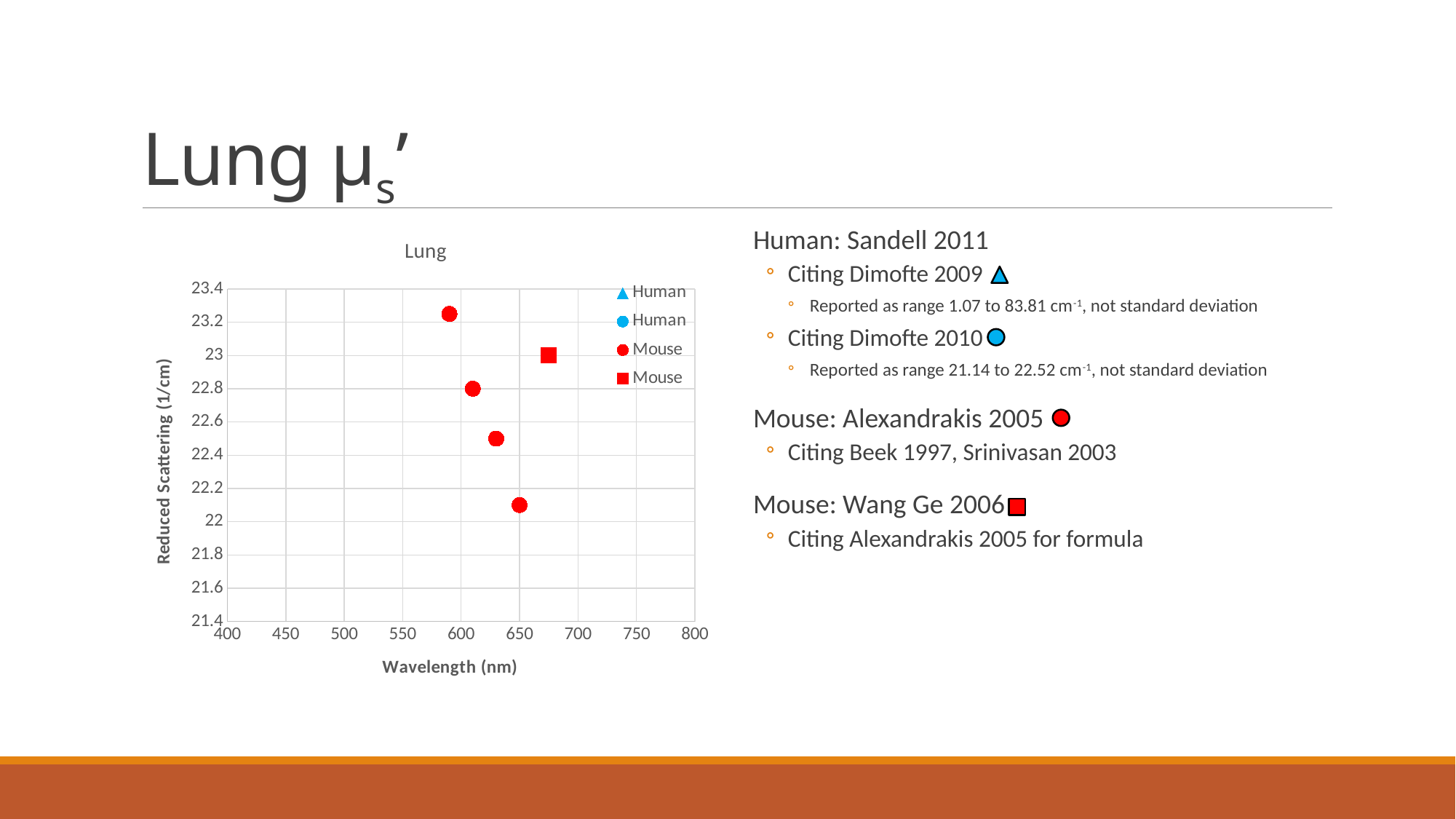
For the red circle Mouse series, does reduced scattering rise or fall as wavelength increases? fall What is the title of the chart? Lung How many series does the legend of the Lung chart list? 4 What is the label of the x axis of the chart? Wavelength (nm) Is the reduced scattering value of the red circle Mouse point at 650 nm greater or less than 22.2? less Is the wavelength of the red square Mouse point greater or less than 650 nm? greater How many red square (Mouse) points are plotted on the Lung chart? 1 What type of chart is shown on the slide? scatter chart Which marker shape has the highest plotted reduced scattering value on the Lung chart? circle Is the reduced scattering value of the red circle Mouse point near 590 nm greater or less than 23? greater How many data points are plotted on the Lung chart? 5